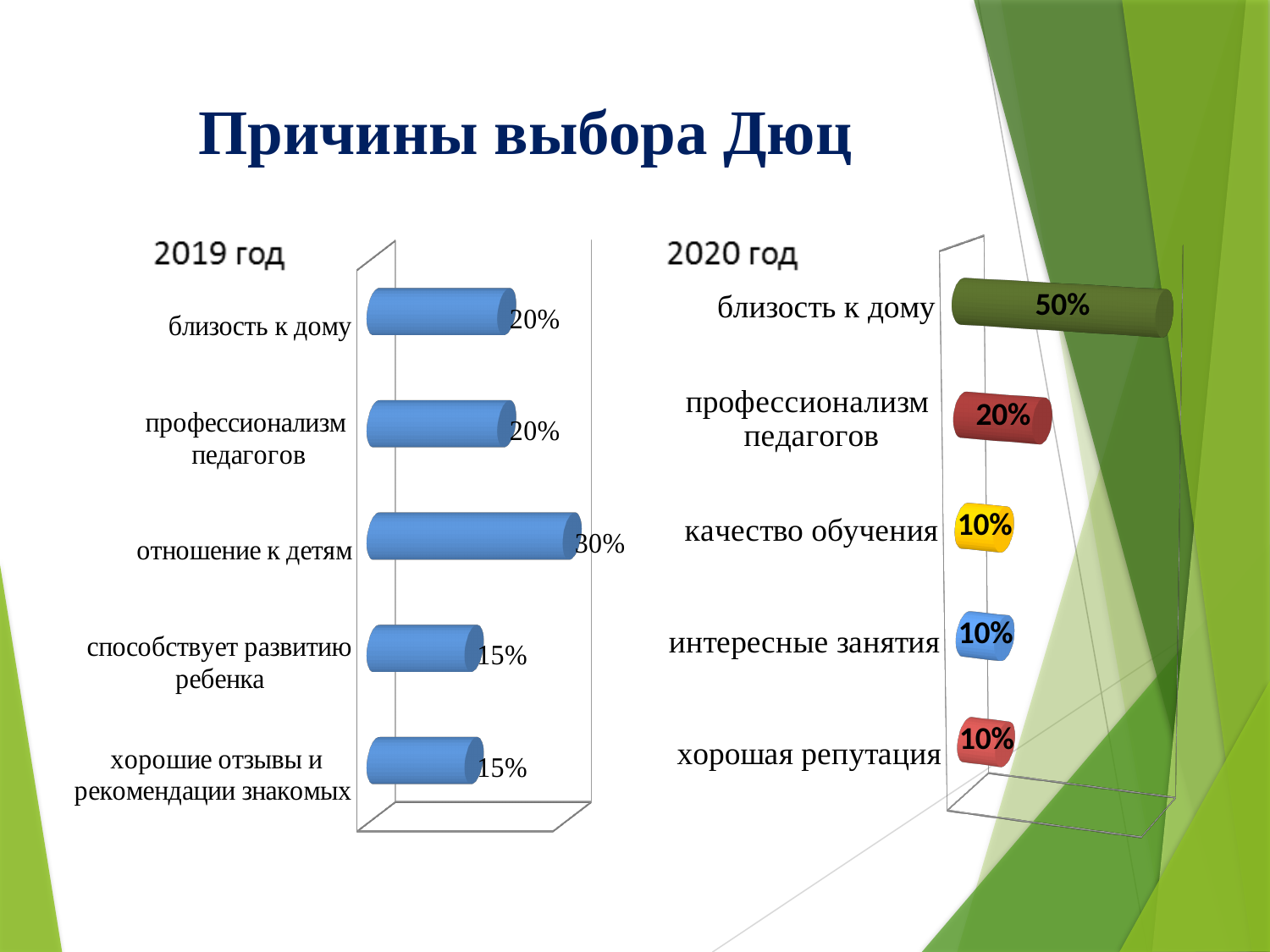
In the 2020 год chart, which category has the highest value? близость к дому In the 2020 год chart, what is the value for качество обучения? 10% In the 2019 год chart, how many categories are shown? 5 In the 2019 год chart, which category has the highest value? отношение к детям In the 2020 год chart, what is the difference between близость к дому and профессионализм педагогов? 30% In the 2019 год chart, what is the value for способствует развитию ребенка? 15% Which is larger: близость к дому in the 2019 год chart or близость к дому in the 2020 год chart? 2020 год In the 2019 год chart, what is the value for отношение к детям? 30% In the 2019 год chart, what is the difference between отношение к детям and хорошие отзывы и рекомендации знакомых? 15% In the 2020 год chart, what colour is the bar for близость к дому? green What type of chart is the 2020 год chart? bar chart In the 2020 год chart, what is the value for близость к дому? 50%